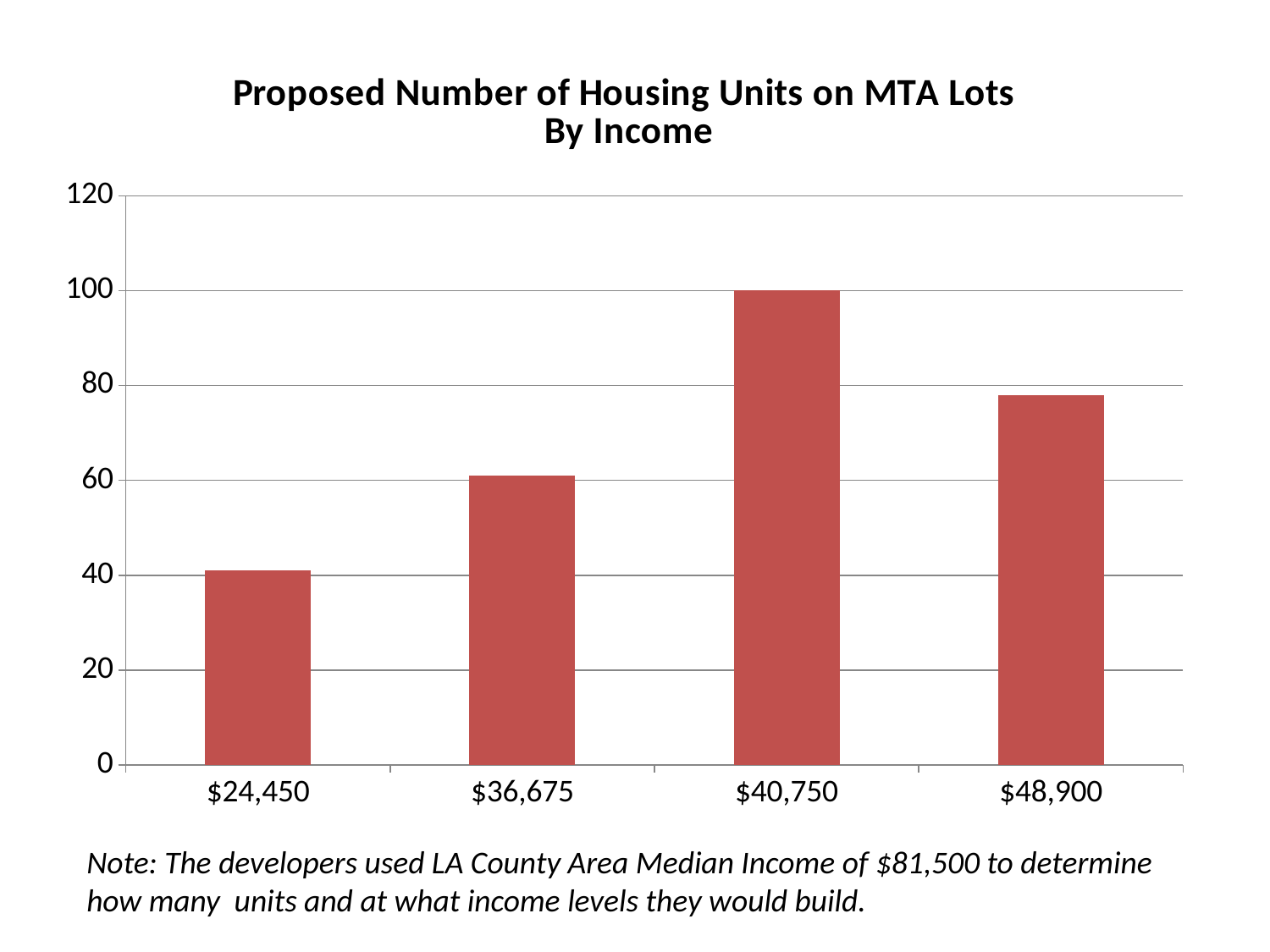
Is the value for $36,675 greater or less than 40? greater Which has more proposed housing units, $36,675 or $48,900? $48,900 Is the value for $36,675 greater or less than 80? less Is the value for $48,900 greater or less than 60? greater Which has more proposed housing units, $24,450 or $36,675? $36,675 Which income level has the highest proposed number of housing units? $40,750 Which income level has the lowest proposed number of housing units? $24,450 What is the proposed number of housing units for the $40,750 income level? 100 What type of chart is shown on the slide? bar chart What is the title of the chart? Proposed Number of Housing Units on MTA Lots By Income How many income categories are shown on the x axis? 4